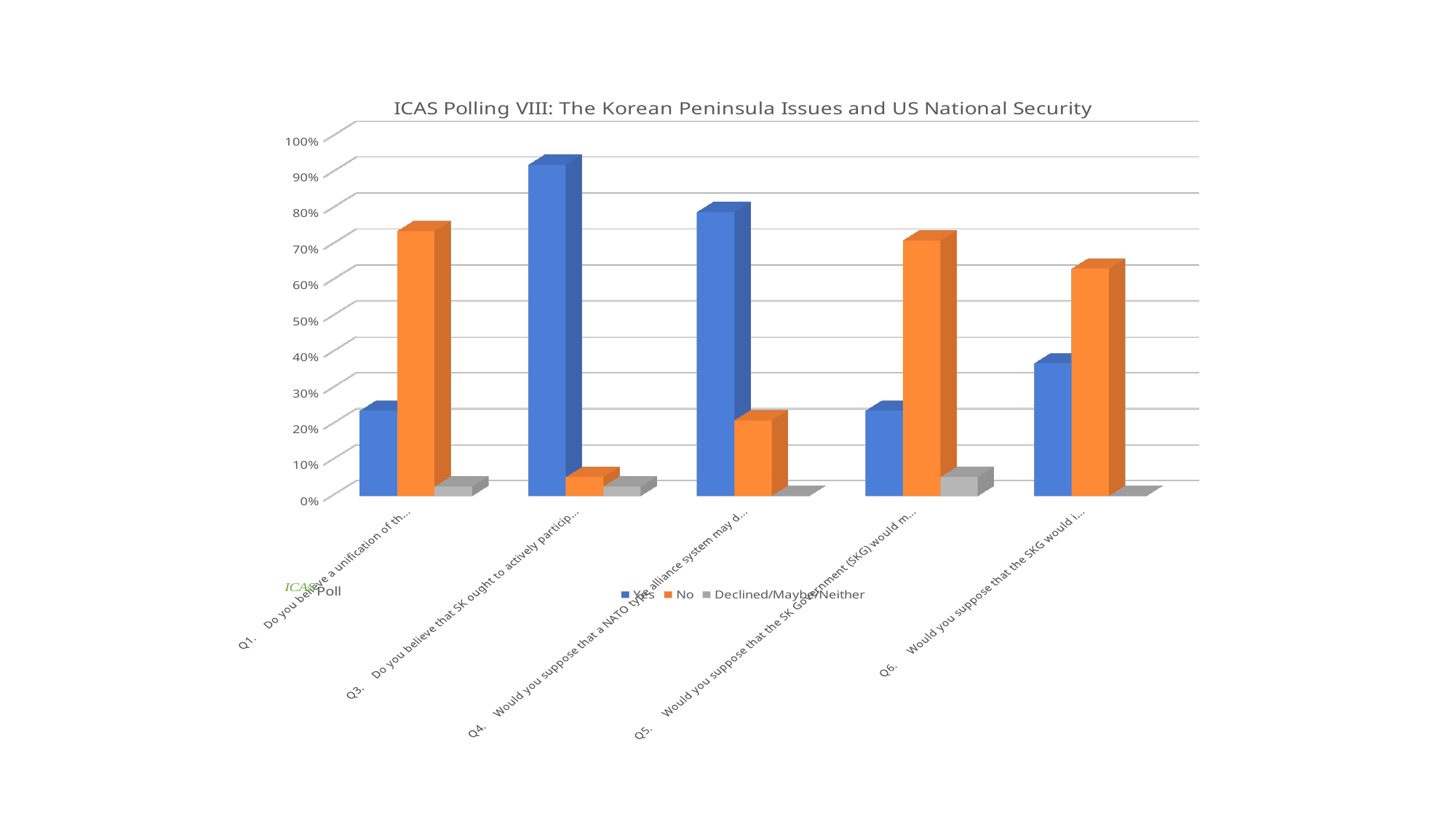
Is the No value for Q1 greater or less than 60%? greater Is the Yes value for Q6 greater or less than 50%? less Which is larger, the Yes value for Q3 or the Yes value for Q4? Q3 What kind of chart is shown on the slide? bar chart Is the Yes value for Q3 greater or less than 80%? greater How many series does the legend list? 3 For Q6, which is larger, the Yes value or the No value? No Which question has the lowest No value? Q3 Which question has the highest Yes value? Q3 Which series is shown in orange in the legend? No What is the title of the chart? ICAS Polling VIII: The Korean Peninsula Issues and US National Security How many question categories are plotted along the x axis? 5